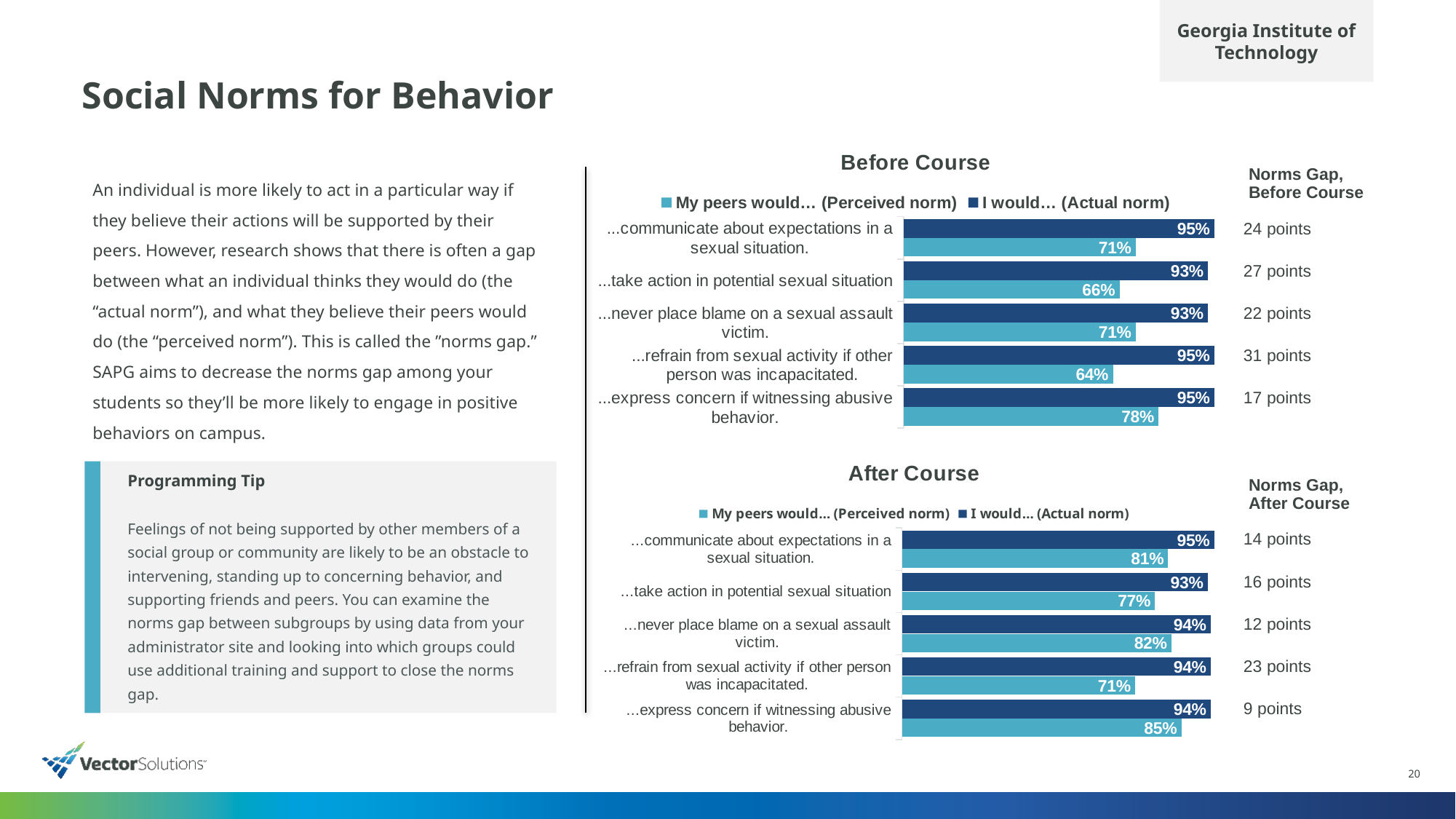
In the After Course chart, what is the value for 'My peers would… (Perceived norm)' for '...express concern if witnessing abusive behavior.'? 85% In the After Course chart, what is the value for 'I would… (Actual norm)' for '...never place blame on a sexual assault victim.'? 94% In the Before Course chart, which category has the lowest 'My peers would… (Perceived norm)' value? ...refrain from sexual activity if other person was incapacitated. How many series does the legend of the After Course chart list? 2 In the Before Course chart, what is the difference between the 'I would… (Actual norm)' and 'My peers would… (Perceived norm)' values for '...take action in potential sexual situation'? 27 points What is the title of the lower chart on the slide? After Course In the After Course chart, which category has the highest 'My peers would… (Perceived norm)' value? ...express concern if witnessing abusive behavior. What kind of chart is the Before Course chart? Bar chart In the Before Course chart, what is the value for 'My peers would… (Perceived norm)' for '...refrain from sexual activity if other person was incapacitated.'? 64% In the After Course chart, which is larger for '...communicate about expectations in a sexual situation.': the 'I would… (Actual norm)' value or the 'My peers would… (Perceived norm)' value? I would… (Actual norm) In the Before Course chart, what is the value for 'I would… (Actual norm)' for '...take action in potential sexual situation'? 93% How many categories does the Before Course chart show? 5